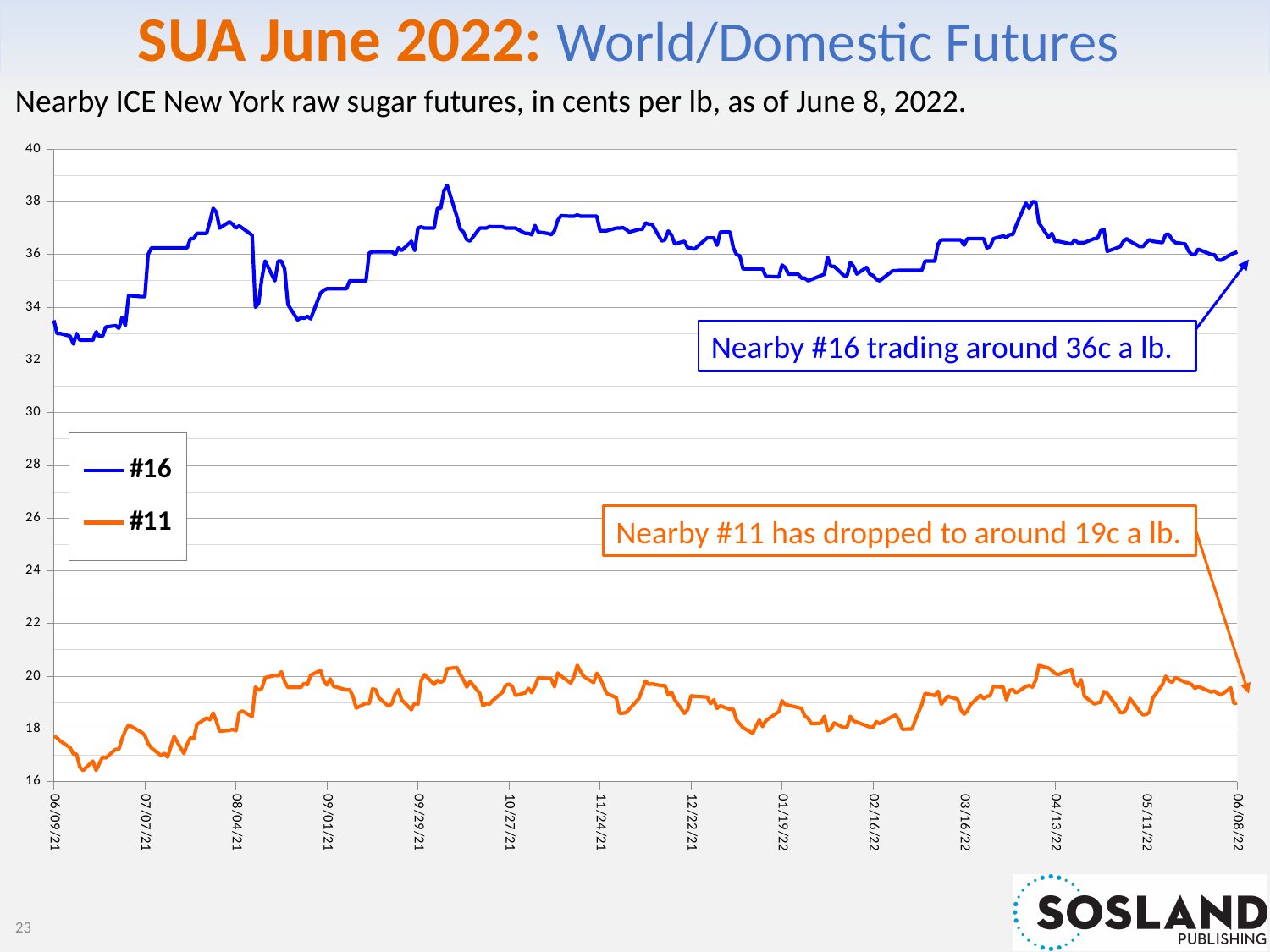
Which series is plotted in blue? #16 Does the #11 series rise or fall between 06/09/21 and 09/01/21? rise How many series does the legend list? 2 Does the #16 series rise or fall between 06/09/21 and 07/07/21? rise What kind of chart is shown on the slide? line chart Which series has the higher values throughout the chart, #16 or #11? #16 According to the annotation on the chart, around what price is Nearby #11 trading? around 19c a lb. Is the value for #16 on 06/08/22 greater or less than 34? greater Is the lowest value of the #11 series greater or less than 18? less Is the value for #11 on 06/08/22 greater or less than 20? less